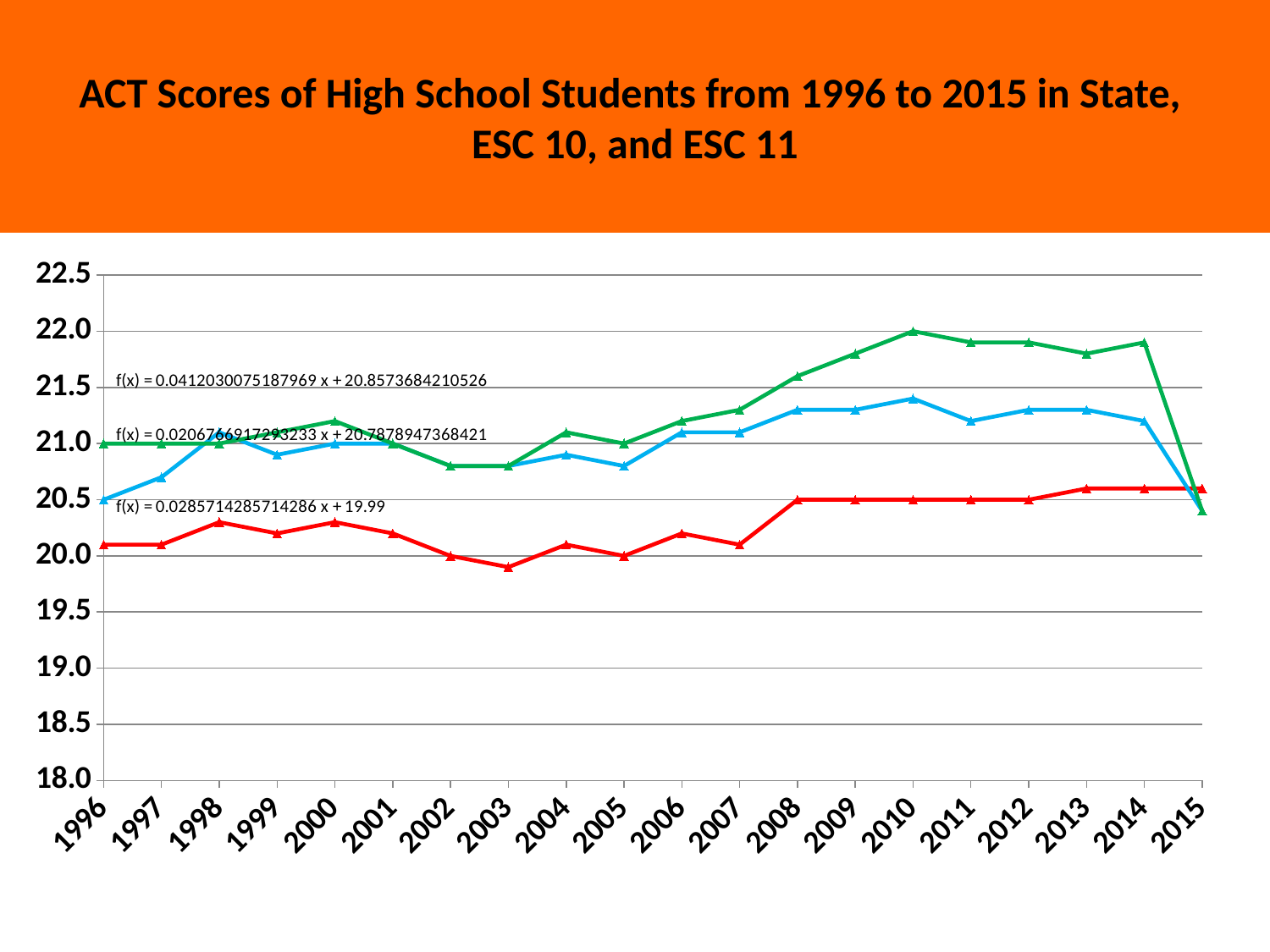
Does the green line rise or fall between 2005 and 2010? rise What is the difference between the green line's value in 2010 and its value in 1996? 1.0 What is the value of the red line in 2002? 20.0 What is the title of the chart? ACT Scores of High School Students from 1996 to 2015 in State, ESC 10, and ESC 11 Is the value of the green line in 2014 greater or less than 21.5? greater What is the value of the green line in 2010? 22.0 Is the value of the red line in 2003 greater or less than 20.0? less What kind of chart is shown on the slide? line chart In 2010, which line has the larger value, the green line or the red line? green line How many years are plotted along the x axis? 20 In which year does the red line reach its lowest value? 2003 In which year does the green line reach its highest value? 2010